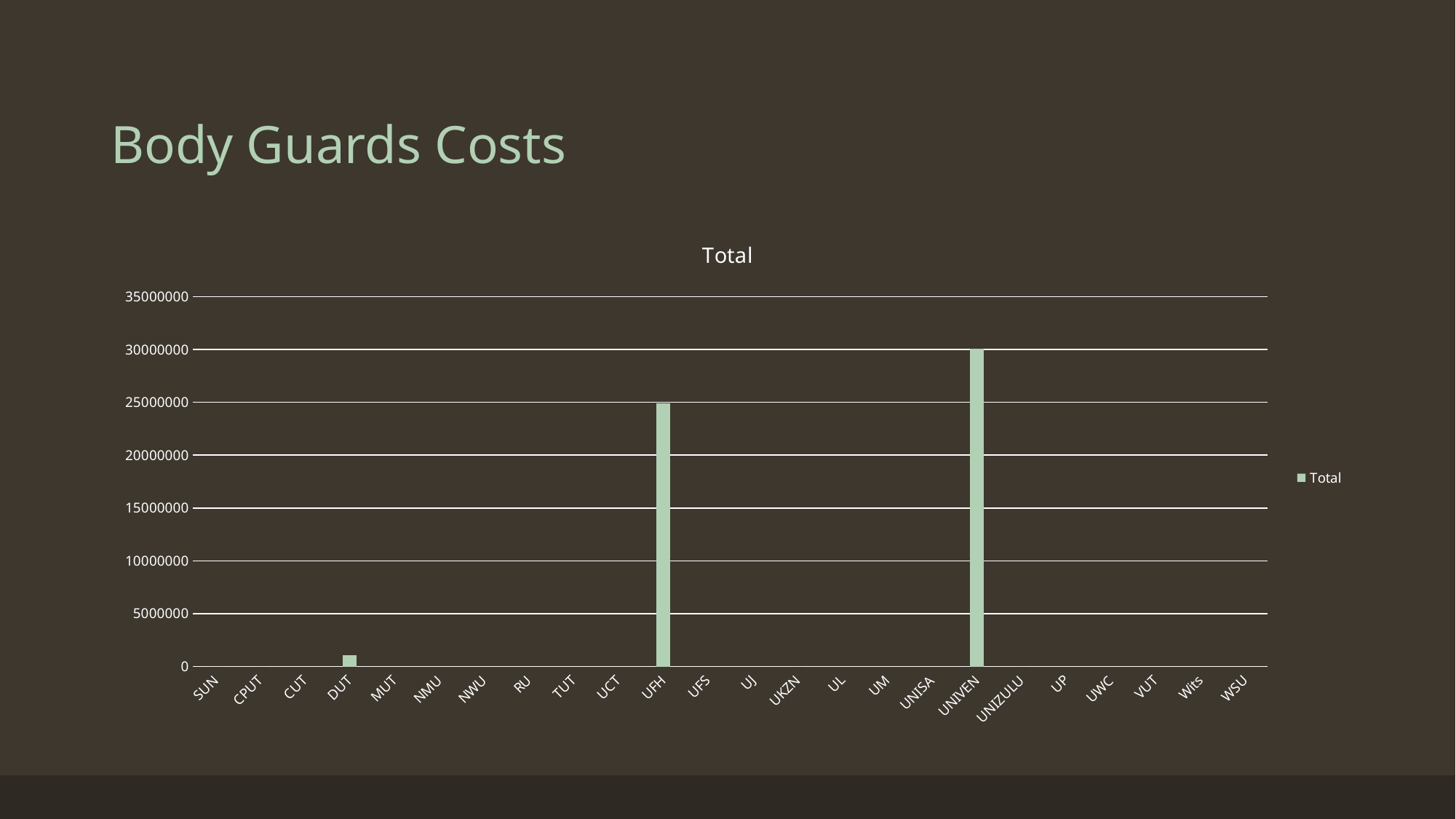
What kind of chart is shown on the slide? bar chart What is the name of the series listed in the legend? Total Which category has the highest value in the chart? UNIVEN Which has the larger value, DUT or UFH? UFH Which has the larger value, UFH or UNIVEN? UNIVEN Is the value for UFH greater or less than 20000000? greater Is the value for UNIVEN greater or less than 25000000? greater How many series does the legend list? 1 How many categories are shown on the x axis of the chart? 24 What is the title of the chart? Total Is the value for DUT greater or less than 5000000? less